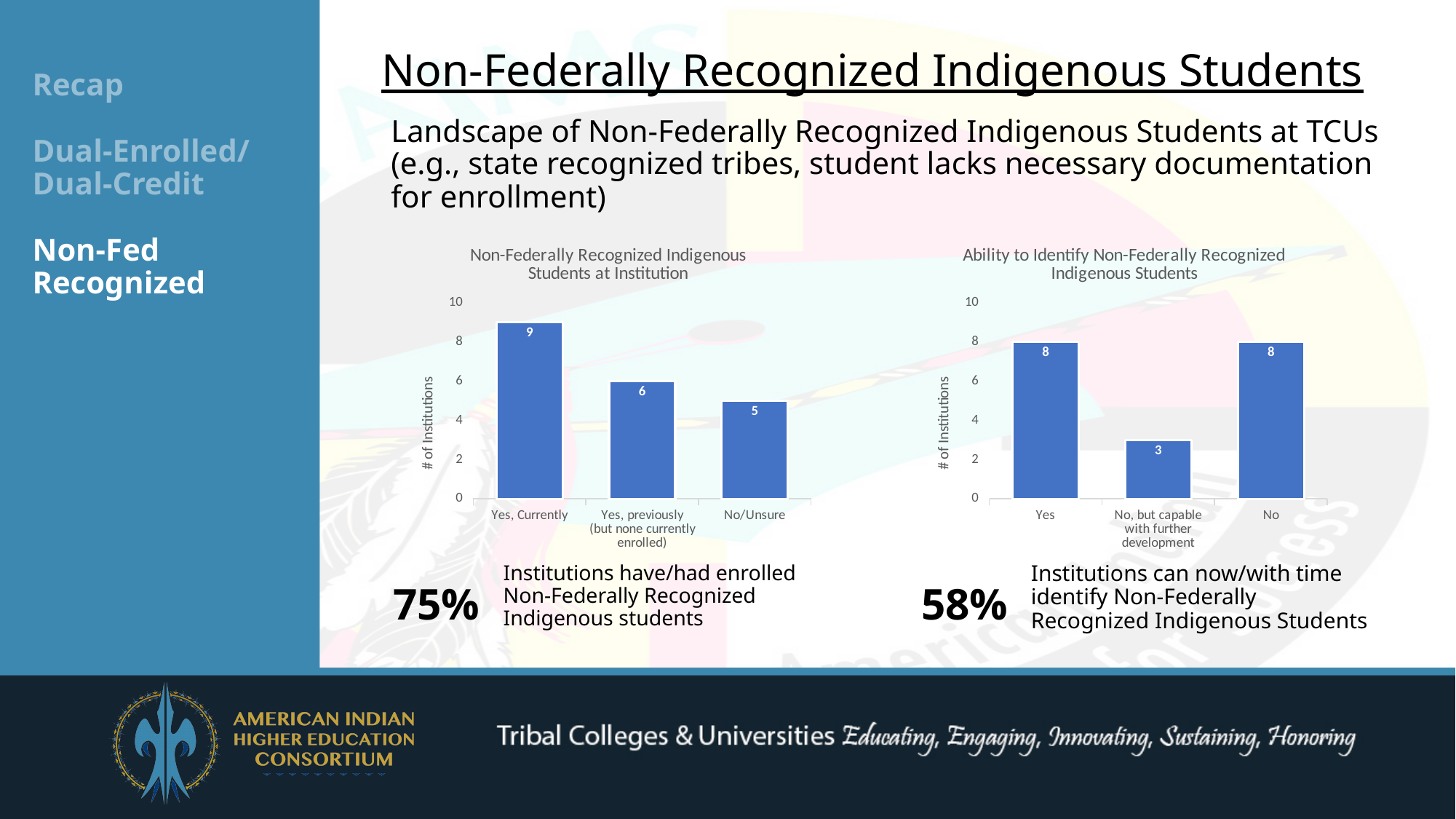
In the chart titled "Ability to Identify Non-Federally Recognized Indigenous Students", what is the difference between "No" and "No, but capable with further development"? 5 In the chart titled "Non-Federally Recognized Indigenous Students at Institution", which category has the highest value? Yes, Currently In the chart titled "Non-Federally Recognized Indigenous Students at Institution", how many categories are shown? 3 What is the y-axis label of the chart titled "Ability to Identify Non-Federally Recognized Indigenous Students"? # of Institutions In the chart titled "Ability to Identify Non-Federally Recognized Indigenous Students", which category has the lowest value? No, but capable with further development In the chart titled "Ability to Identify Non-Federally Recognized Indigenous Students", what is the value for "Yes"? 8 In the chart titled "Non-Federally Recognized Indigenous Students at Institution", what is the value for "No/Unsure"? 5 In the chart titled "Non-Federally Recognized Indigenous Students at Institution", what is the value for "Yes, Currently"? 9 In the chart titled "Non-Federally Recognized Indigenous Students at Institution", what is the difference between "Yes, Currently" and "Yes, previously (but none currently enrolled)"? 3 What kind of chart is the chart titled "Non-Federally Recognized Indigenous Students at Institution"? Bar chart In the chart titled "Ability to Identify Non-Federally Recognized Indigenous Students", what is the value for "No, but capable with further development"? 3 In the chart titled "Ability to Identify Non-Federally Recognized Indigenous Students", which is larger, the value for "Yes" or the value for "No, but capable with further development"? Yes